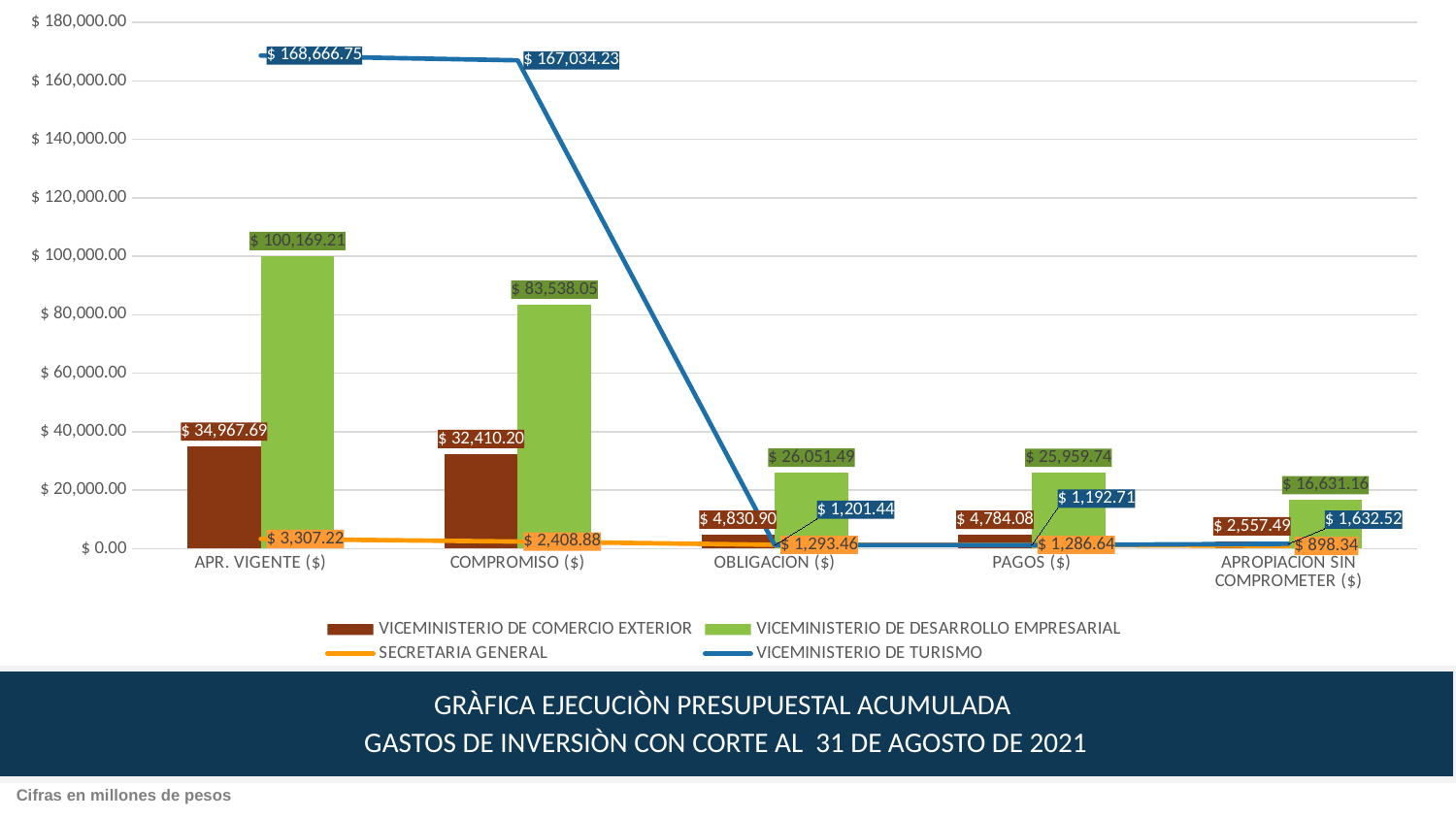
What is the value for VICEMINISTERIO DE DESARROLLO EMPRESARIAL in the APR. VIGENTE ($) category? $ 100,169.21 What kind of chart is shown on the slide? A combined bar and line chart What is the difference between the VICEMINISTERIO DE DESARROLLO EMPRESARIAL values for APR. VIGENTE ($) and COMPROMISO ($)? $ 16,631.16 What is the value for VICEMINISTERIO DE TURISMO in the COMPROMISO ($) category? $ 167,034.23 In which category does VICEMINISTERIO DE TURISMO reach its highest value? APR. VIGENTE ($) What is the value for VICEMINISTERIO DE COMERCIO EXTERIOR in the PAGOS ($) category? $ 4,784.08 How many series does the legend list? 4 Which series is drawn as a blue line? VICEMINISTERIO DE TURISMO In which category does VICEMINISTERIO DE DESARROLLO EMPRESARIAL have its lowest value? APROPIACION SIN COMPROMETER ($) Which is larger in the OBLIGACION ($) category: VICEMINISTERIO DE COMERCIO EXTERIOR or VICEMINISTERIO DE TURISMO? VICEMINISTERIO DE COMERCIO EXTERIOR What is the value for SECRETARIA GENERAL in the APROPIACION SIN COMPROMETER ($) category? $ 898.34 How many categories are shown on the x axis? 5